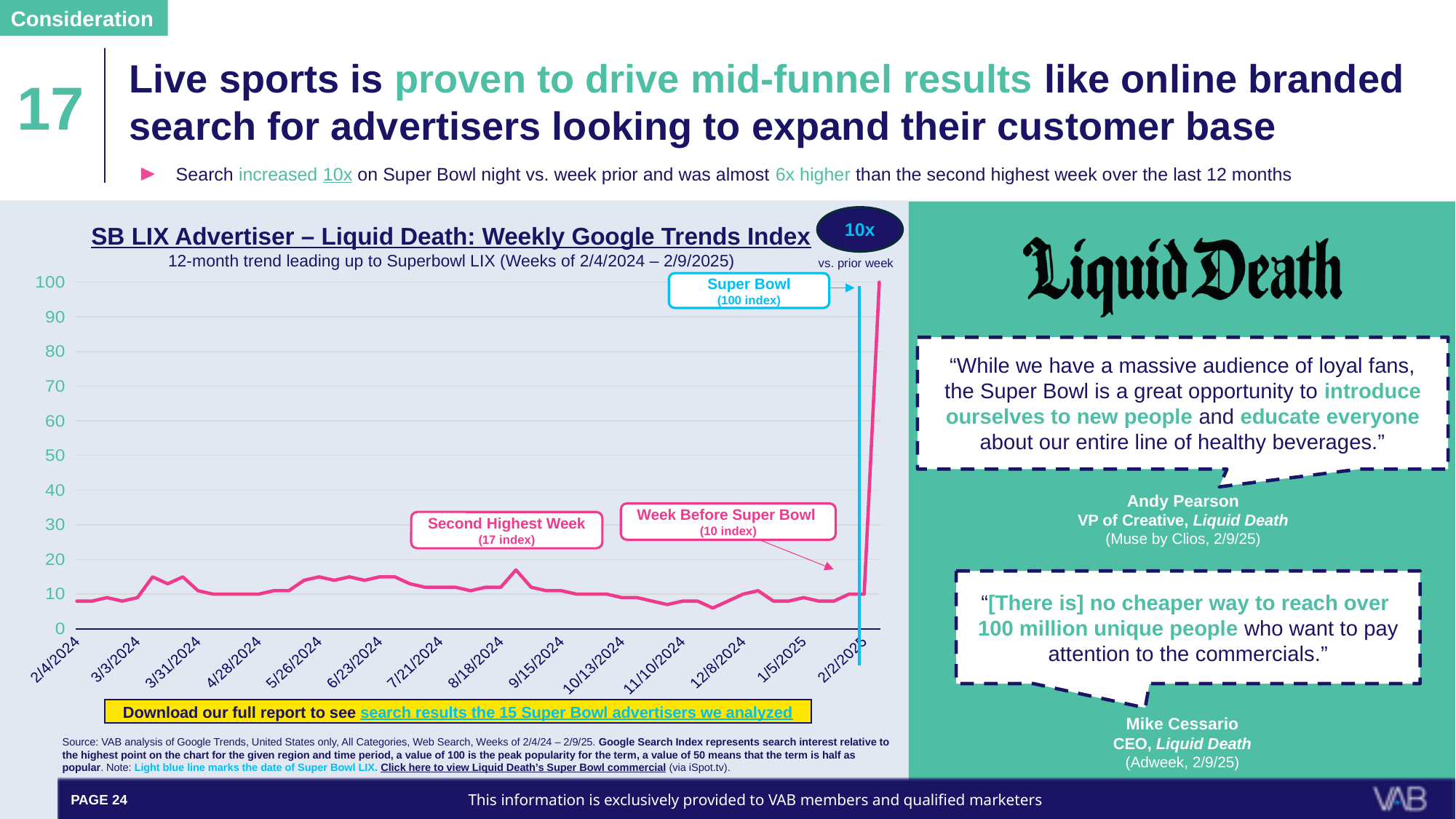
What is the index value for the week before the Super Bowl? 10 Is the index value for the week of 2/4/2024 greater or less than 20? less According to the note, what does the light blue vertical line on the chart mark? the date of Super Bowl LIX What kind of chart is shown on the slide? line chart What is the index value for the second highest week? 17 Which week has the highest index value on the chart? Super Bowl week What is the difference between the Super Bowl week index and the second highest week index? 83 What is the title of the chart? SB LIX Advertiser – Liquid Death: Weekly Google Trends Index What is the Google Trends index value for the Super Bowl week? 100 How much higher is the Super Bowl week index than the week before the Super Bowl? 90 Which is larger: the index for the second highest week or the index for the week before the Super Bowl? second highest week How many date labels are shown on the x axis? 14